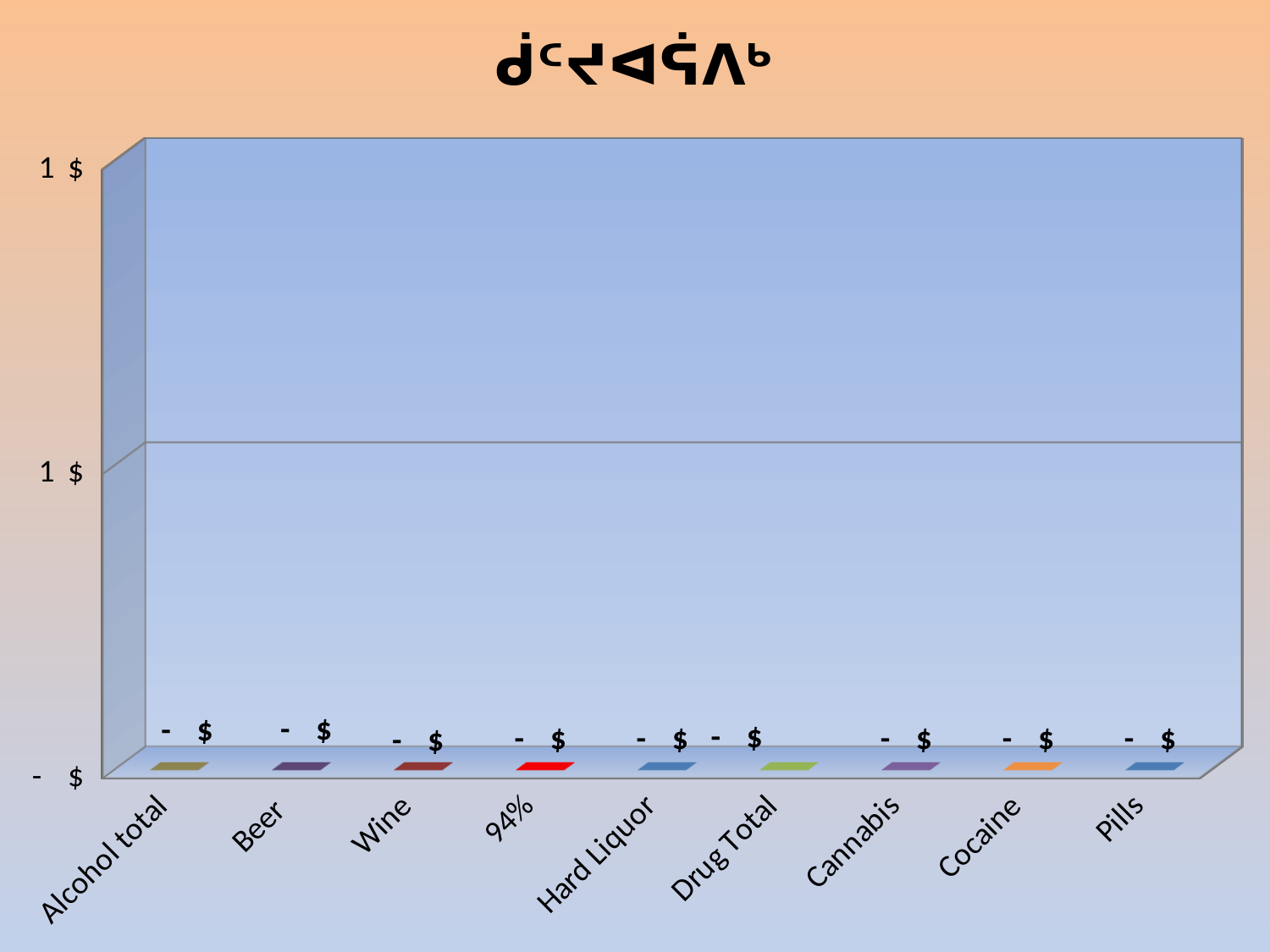
How many categories are shown on the x axis of the chart? 9 Is the value for Cocaine greater or less than 1 $? less Which category label appears last (rightmost) on the x axis? Pills What data label is printed above the bar for Cannabis? - $ What data label is printed above the bar for Drug Total? - $ Is the value for Wine greater or less than 1 $? less What kind of chart is shown on the slide? bar chart Which category label appears first (leftmost) on the x axis? Alcohol total What data label is printed above the bar for Beer? - $ What colour is the bar for Wine? red